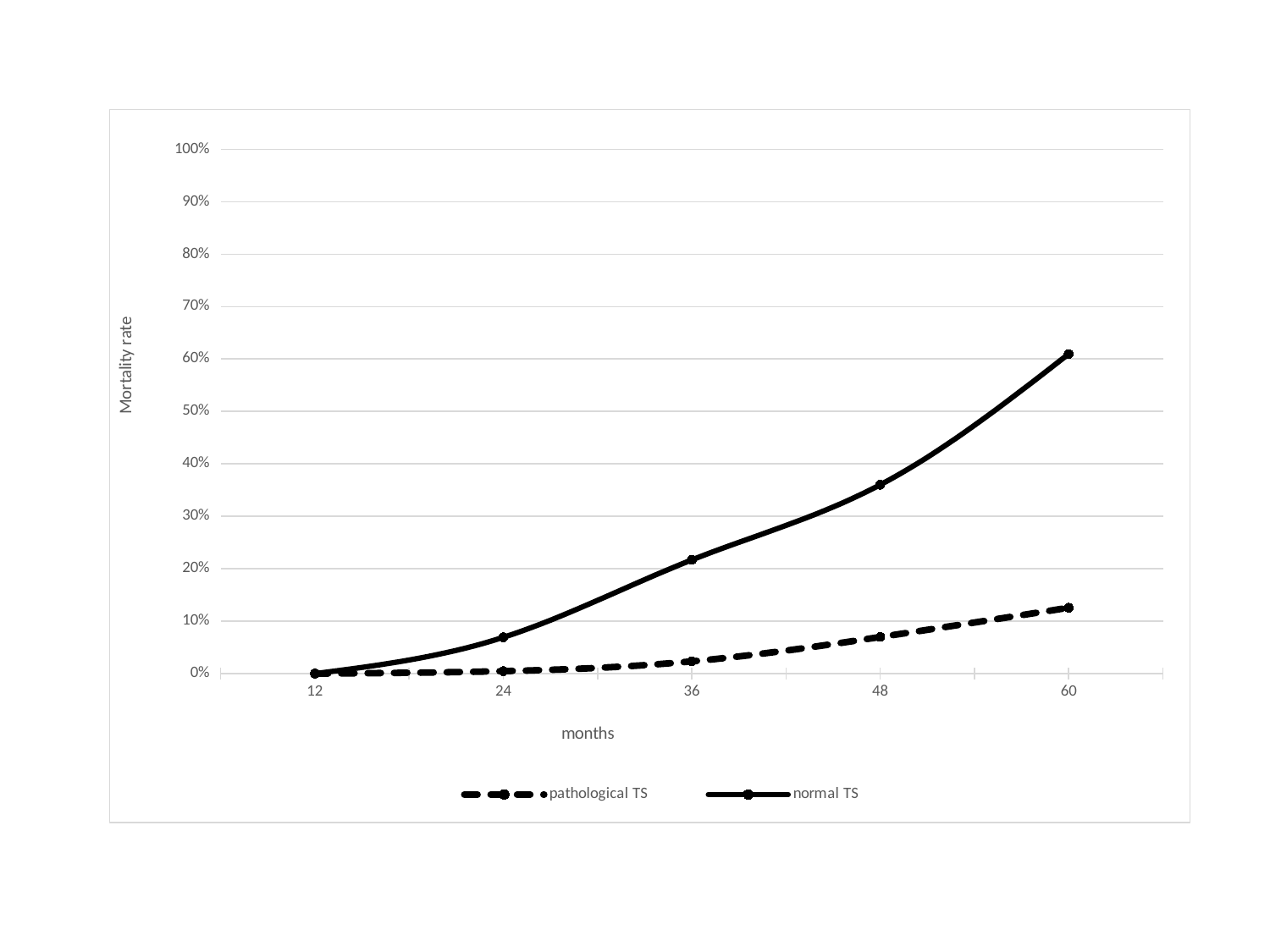
Does the mortality rate for normal TS rise or fall as months increase? rise Is the mortality rate for normal TS at 60 months greater or less than 50%? greater Is the mortality rate for pathological TS at 60 months greater or less than 20%? less Is the mortality rate for normal TS at 24 months greater or less than 10%? less At which month is the mortality rate for normal TS highest? 60 How many time points are plotted along the x axis? 5 What kind of chart is shown on the slide? line chart At 60 months, which series has the higher mortality rate, pathological TS or normal TS? normal TS What is the label of the y axis? Mortality rate How many series does the legend list? 2 Does the mortality rate for pathological TS rise or fall from 12 to 60 months? rise